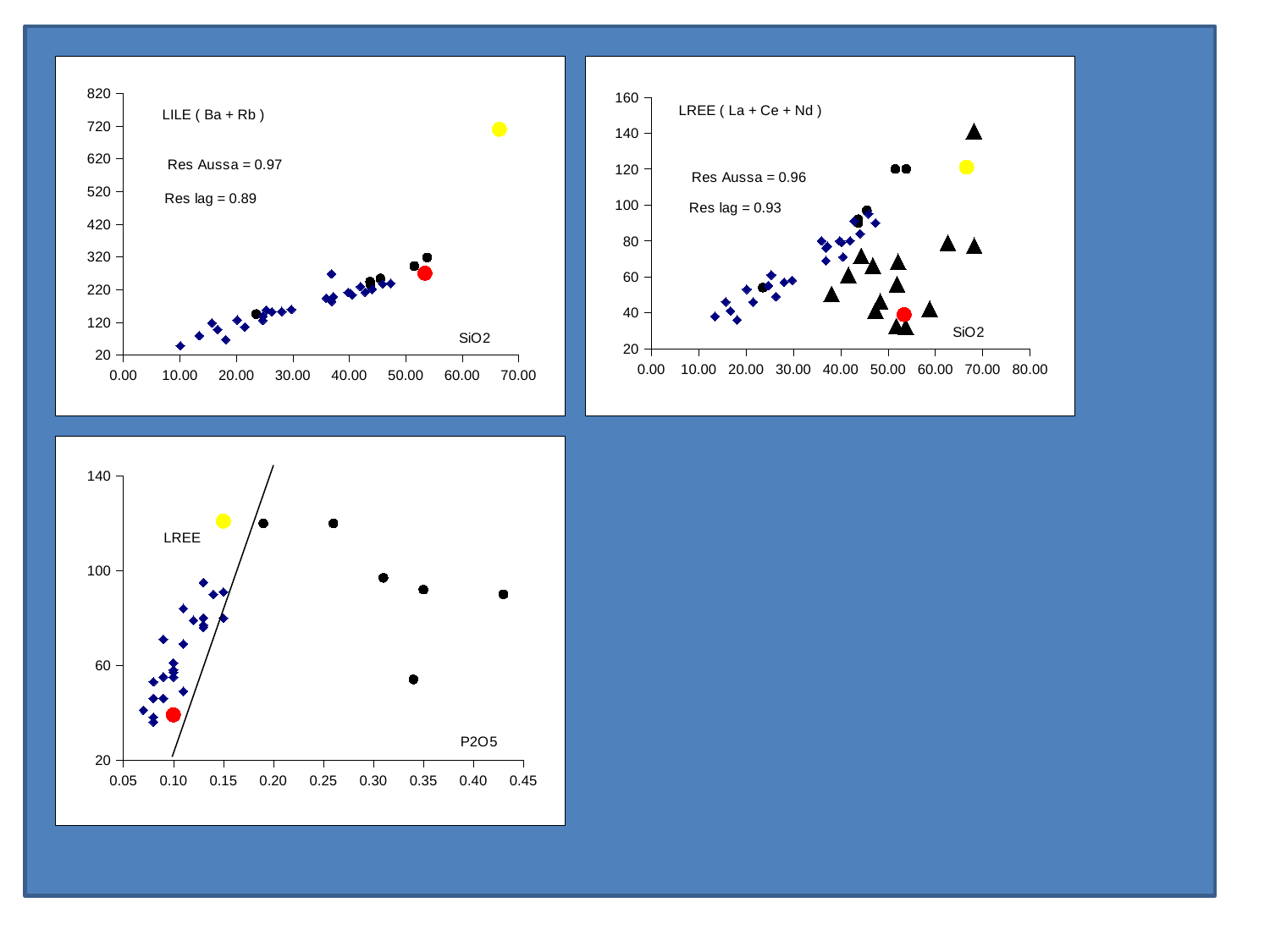
In the top-left chart titled LILE ( Ba + Rb ), is the value of the red point greater or less than 220? greater In the top-left chart titled LILE ( Ba + Rb ), do the values generally rise or fall as SiO2 increases? rise In the bottom-left chart titled LREE, is the lowest black circle point greater or less than 60? less In the top-left chart titled LILE ( Ba + Rb ), is the value of the red point greater or less than 320? less What kind of chart is the top-left chart titled LILE ( Ba + Rb )? scatter chart What kind of chart is the bottom-left chart titled LREE? scatter chart What is the x-axis label of the bottom-left chart titled LREE? P2O5 What value of Res Aussa is printed on the top-left chart titled LILE ( Ba + Rb )? 0.97